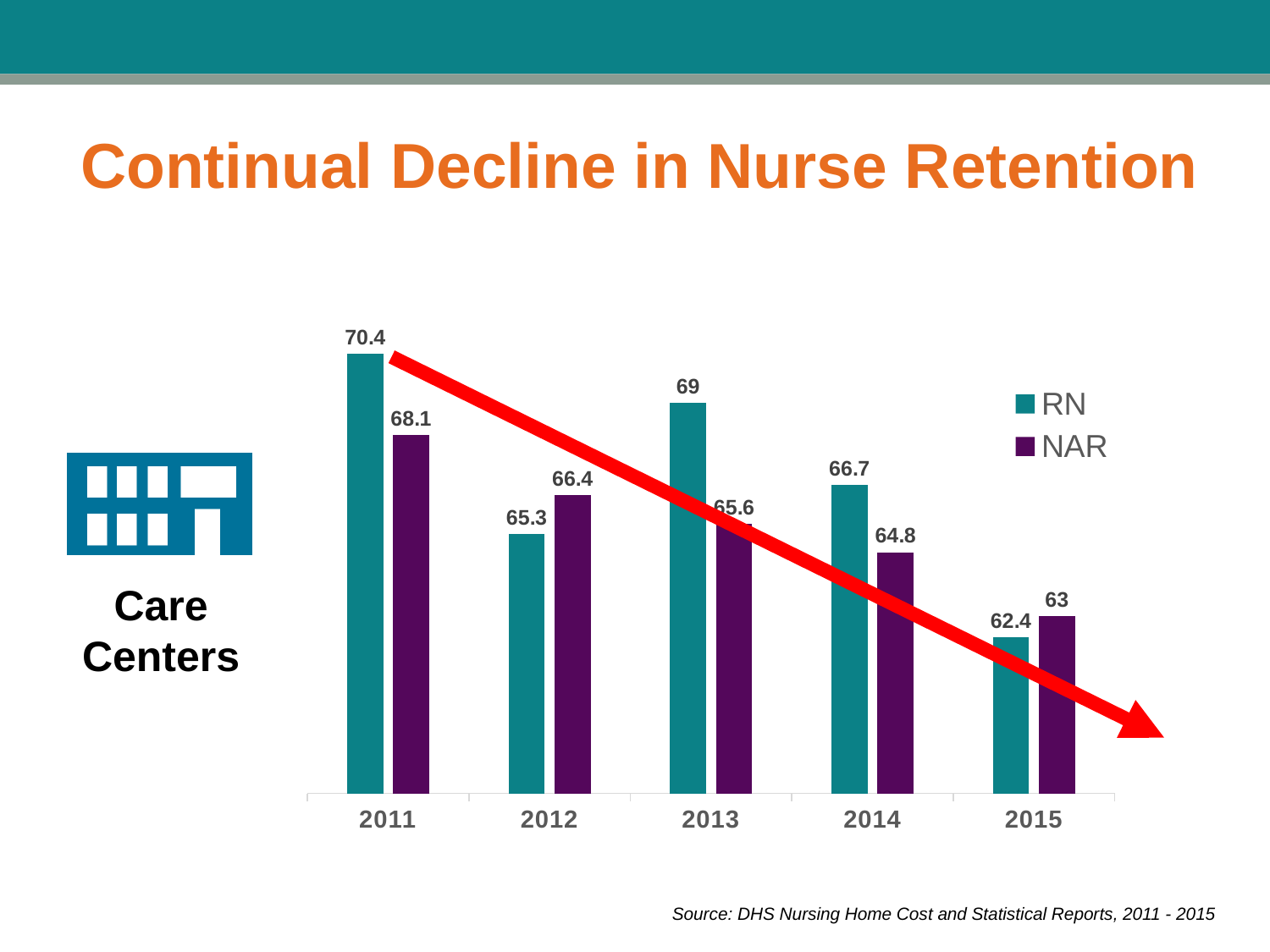
What is the NAR value for 2014? 64.8 Which year has the lowest NAR value? 2015 What is the difference between the RN value in 2011 and the RN value in 2015? 8 Does the RN value rise or fall from 2013 to 2015? Fall How many series does the legend list? 2 What kind of chart is shown on the slide? Bar chart Which year has the highest RN value? 2011 What is the NAR value for 2012? 66.4 What is the RN value for 2011? 70.4 What is the RN value for 2015? 62.4 How many years are shown on the x axis? 5 In 2012, which is larger, the RN value or the NAR value? NAR